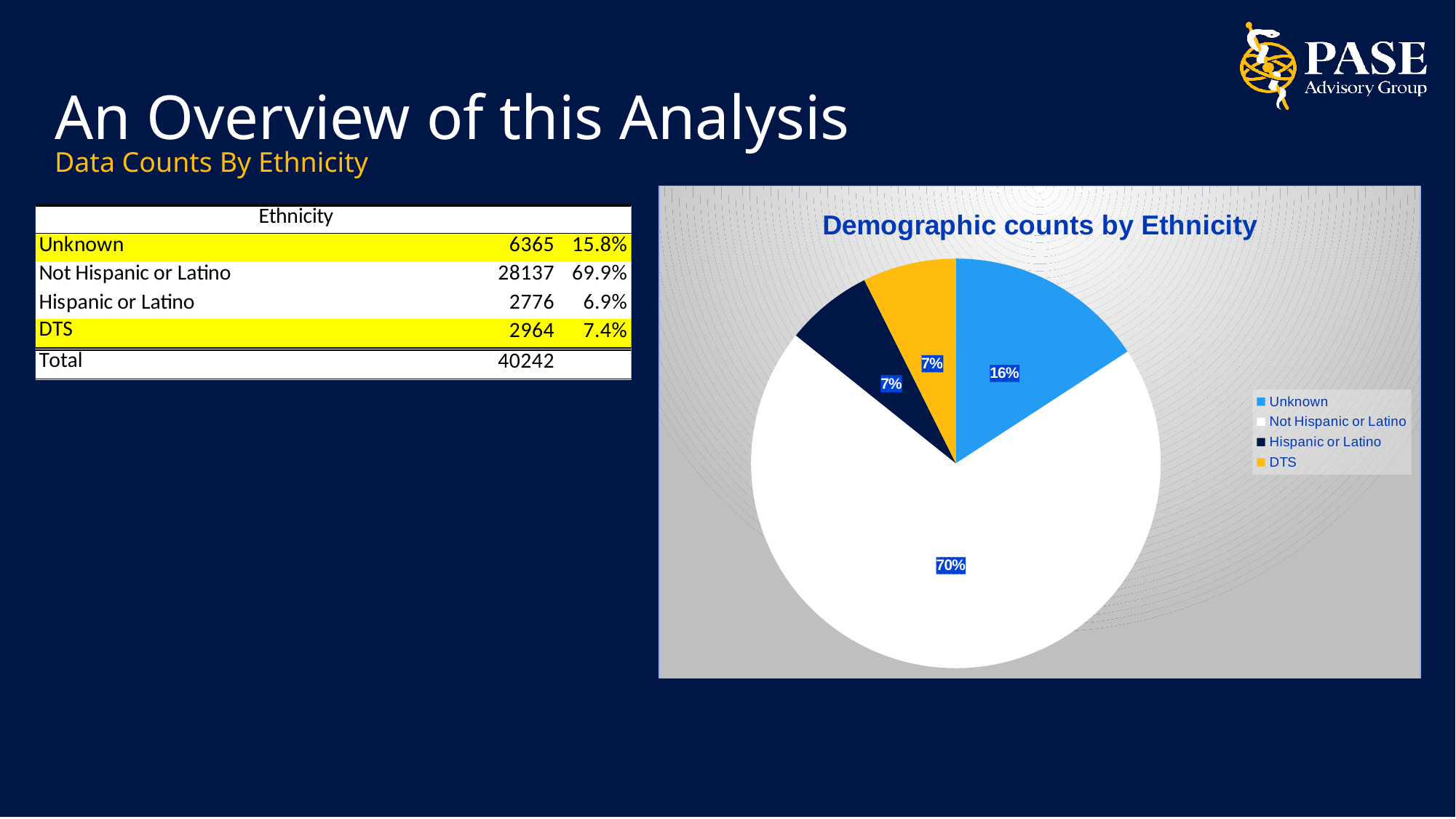
What share of the pie does the Not Hispanic or Latino slice represent? 70% How many slices does the pie chart have? 4 Which slice is larger, Unknown or DTS? Unknown Which legend entry is shown in yellow? DTS What is the difference in percentage points between the Not Hispanic or Latino slice and the Unknown slice? 54 What share of the pie does the Hispanic or Latino slice represent? 7% What share of the pie does the DTS slice represent? 7% Which category has the largest slice of the pie? Not Hispanic or Latino What is the title of the chart? Demographic counts by Ethnicity How many entries does the chart legend list? 4 What type of chart is shown on the slide? Pie chart